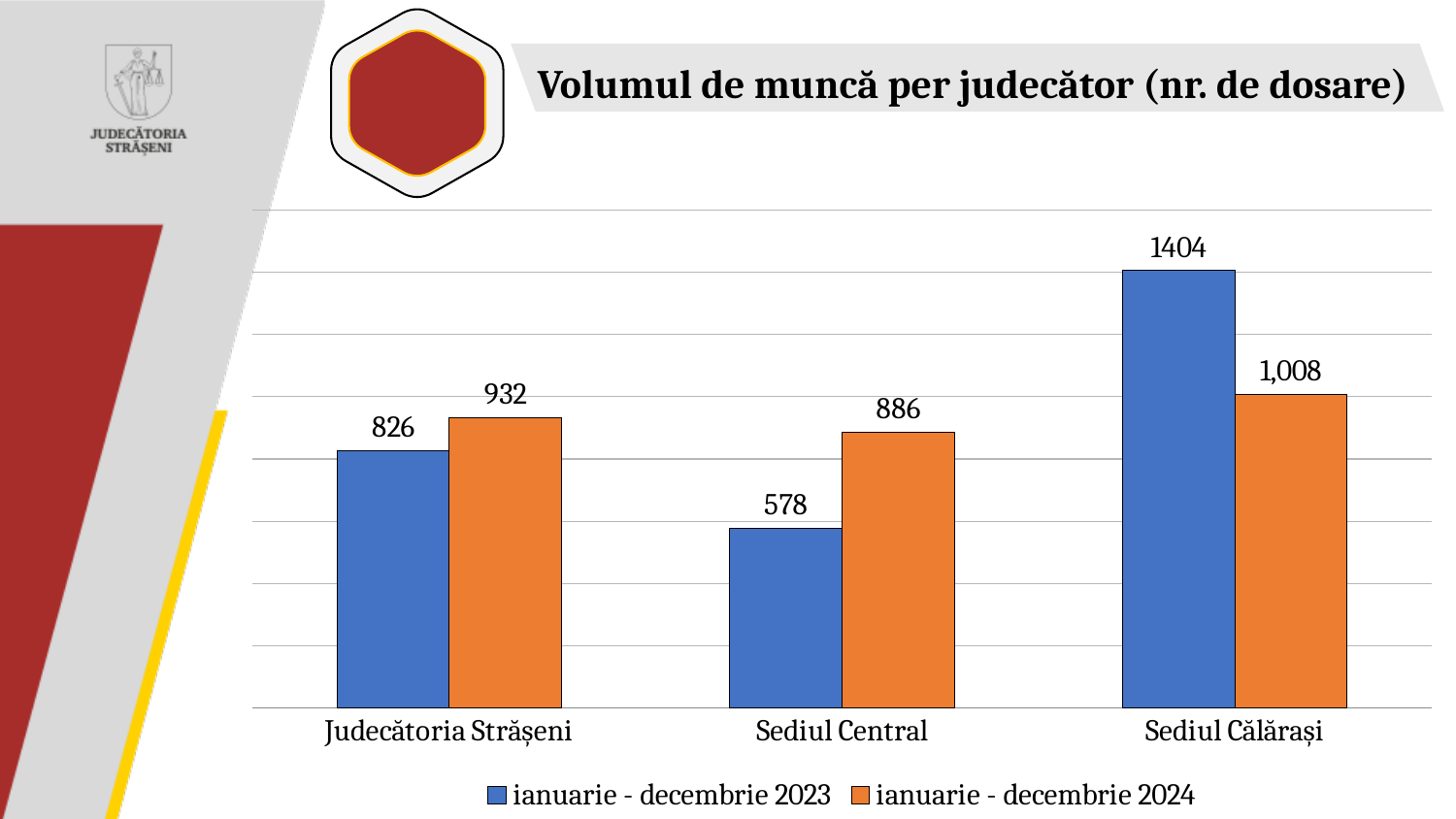
Which category has the highest value in the ianuarie - decembrie 2023 series? Sediul Călărași What is the difference between the 2024 and 2023 values for Sediul Central? 308 What is the value for Sediul Călărași in the ianuarie - decembrie 2024 series? 1,008 For Judecătoria Strășeni, which series has the larger value: ianuarie - decembrie 2023 or ianuarie - decembrie 2024? ianuarie - decembrie 2024 How many series does the legend list? 2 What is the value for Sediul Central in the ianuarie - decembrie 2023 series? 578 What is the difference between the 2023 and 2024 values for Sediul Călărași? 396 What kind of chart is shown on the slide? Bar chart Which category has the lowest value in the ianuarie - decembrie 2024 series? Sediul Central What is the title of the chart? Volumul de muncă per judecător (nr. de dosare) What is the value for Judecătoria Strășeni in the ianuarie - decembrie 2024 series? 932 How many categories are shown on the x axis? 3